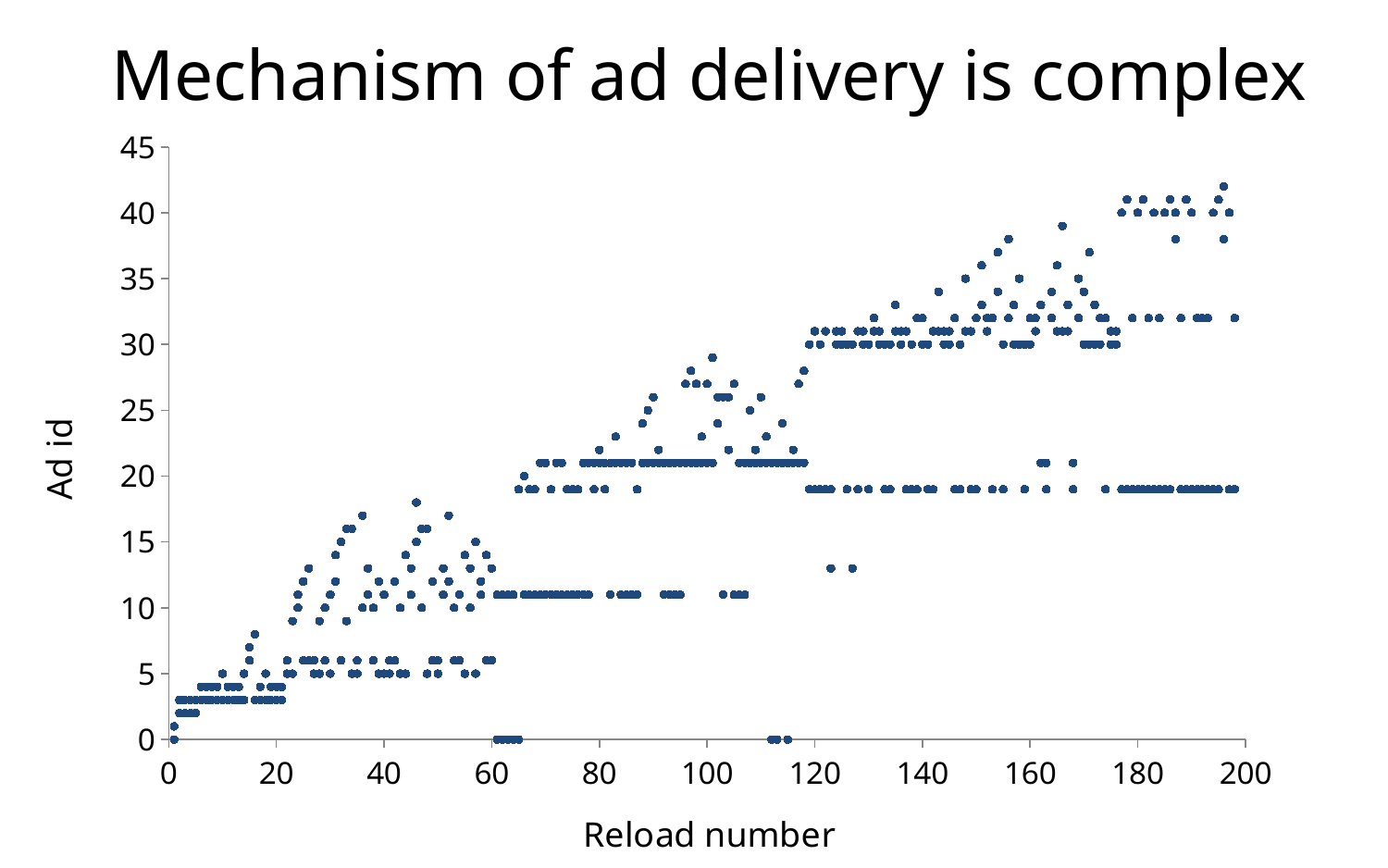
Do the ad id values generally rise or fall as the reload number increases? rise Is the highest ad id plotted between reload numbers 20 and 60 greater or less than 15? greater Is the lowest ad id plotted at reload numbers above 180 greater or less than 15? greater Are the ad ids plotted at reload numbers below 10 greater or less than 5? less What is the label of the y axis? Ad id What is the title of the chart? Mechanism of ad delivery is complex Which has higher ad ids overall: the points near reload number 20 or the points near reload number 180? the points near reload number 180 What kind of chart is shown on the slide? scatter chart